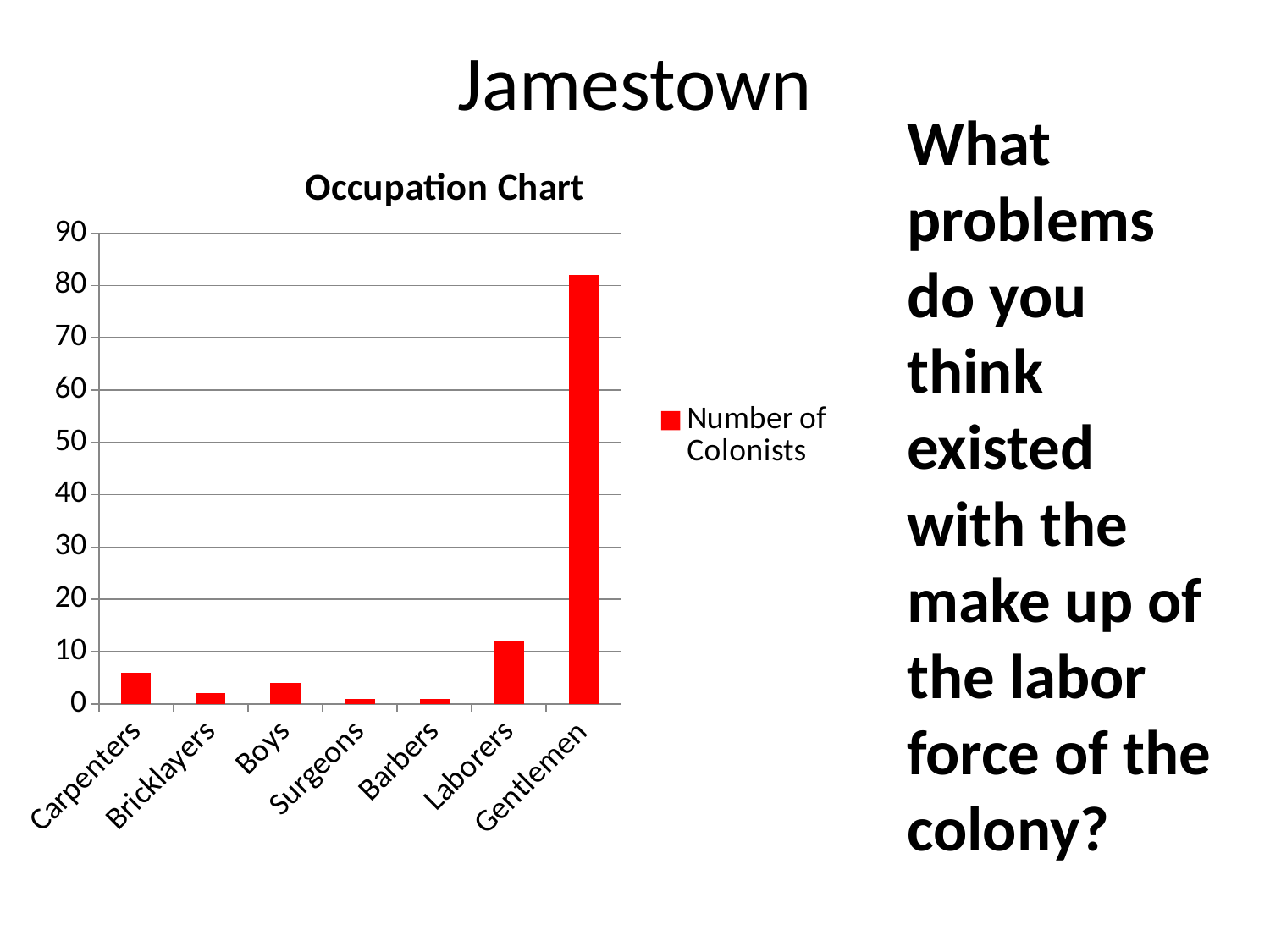
Is the value for Laborers greater or less than 10? greater How many series does the legend list? 1 Which occupation has the highest number of colonists? Gentlemen How many occupation categories are shown on the x axis? 7 Is the value for Gentlemen greater or less than 80? greater Which is larger, the value for Laborers or the value for Carpenters? Laborers What is the title of the chart? Occupation Chart What series name is shown in the legend? Number of Colonists What type of chart is the Occupation Chart? bar chart Is the value for Carpenters greater or less than 10? less Which is larger, the value for Carpenters or the value for Bricklayers? Carpenters